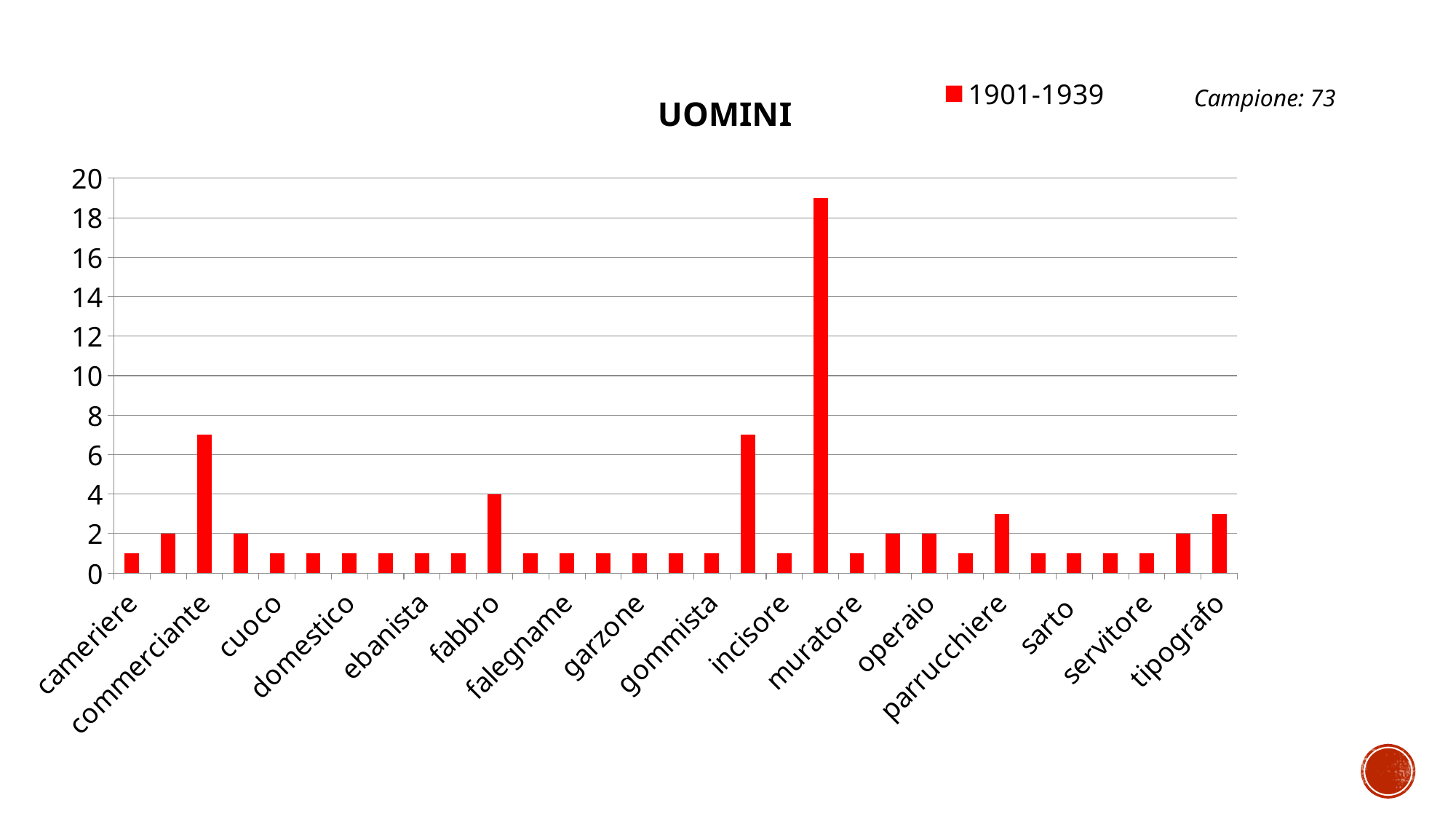
Is the value for commerciante greater or less than 6? greater Which is larger, the value for commerciante or the value for fabbro? commerciante What kind of chart is shown on the slide? bar chart What series name is shown in the legend? 1901-1939 What is the value for fabbro? 4 What is the title of the chart? UOMINI Is the value for parrucchiere greater or less than 2? greater Is the value for cameriere greater or less than 2? less Which is larger, the value for fabbro or the value for tipografo? fabbro What is the value for operaio? 2 What is the difference between the values for fabbro and operaio? 2 How many series does the legend list? 1